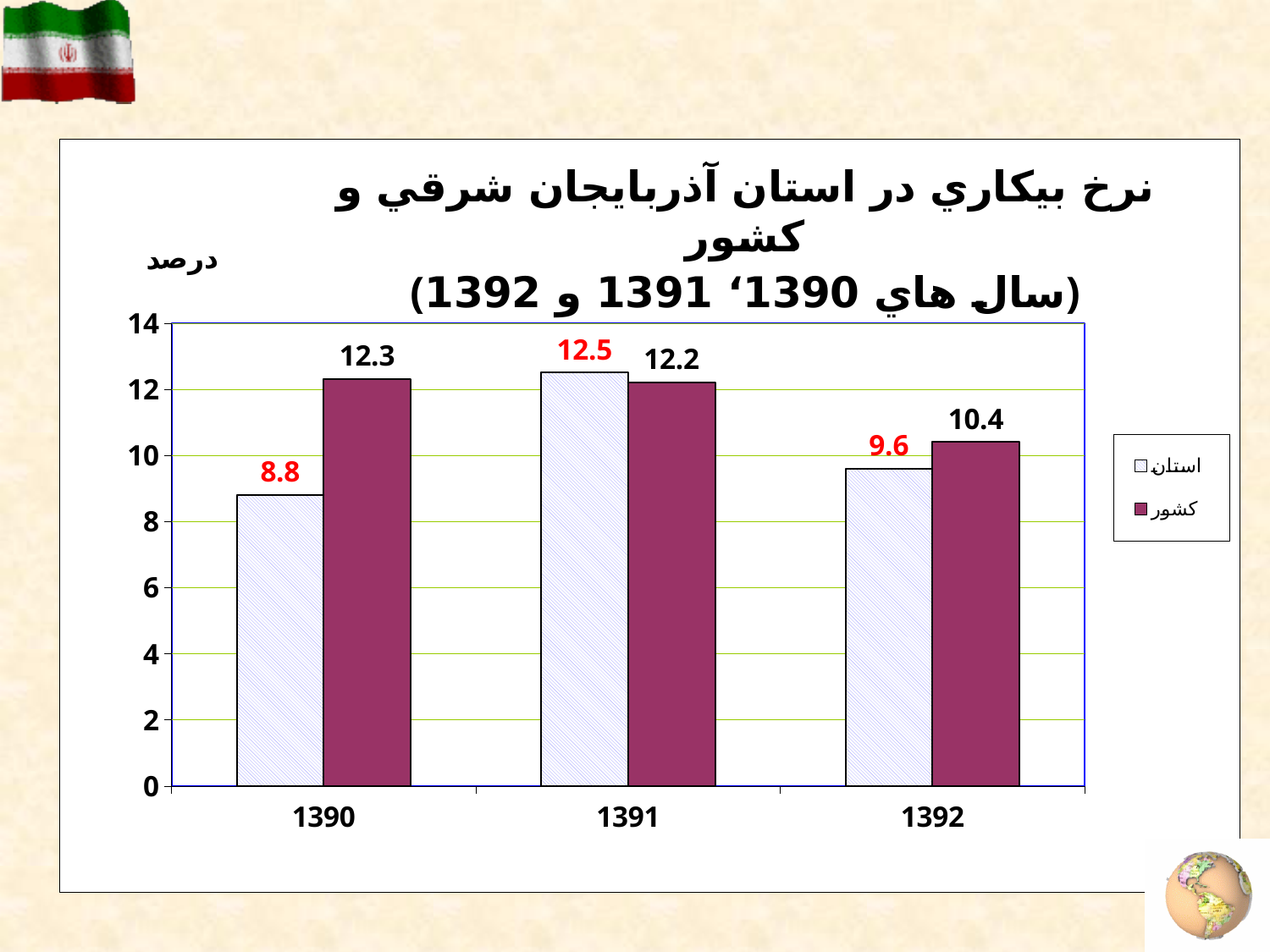
In which year is the value for کشور (country) highest? 1390 In which year is the value for استان (province) lowest? 1390 What is the difference between the کشور (country) and استان (province) values in 1390? 3.5 How many years are shown on the x axis? 3 What kind of chart is shown on the slide? bar chart What is the value for کشور (country) in 1392? 10.4 How many series does the legend list? 2 What is the value for استان (province) in 1390? 8.8 Does the value for کشور (country) rise or fall from 1390 to 1392? fall Is the value for استان (province) in 1392 greater or less than 10? less Which is larger in 1391, the value for استان (province) or for کشور (country)? استان (province) What is the value for استان (province) in 1391? 12.5